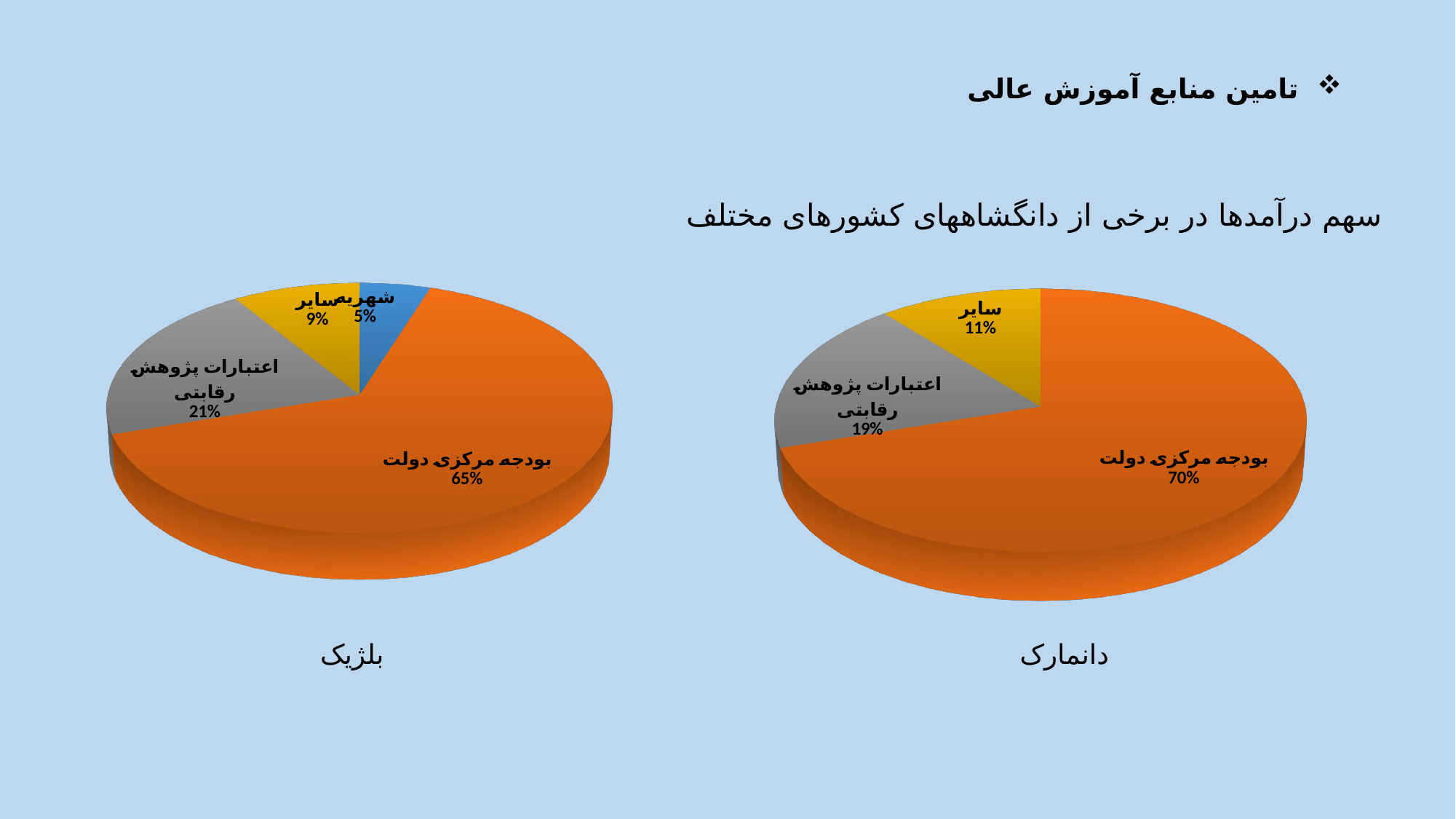
What is the difference between the بودجه مرکزی دولت share in the Denmark chart (right) and in the Belgium chart (left)? 5% Which chart shows a larger share for اعتبارات پژوهش رقابتی, the Belgium chart (left) or the Denmark chart (right)? Belgium (بلژیک) In the Denmark (دانمارک) pie chart on the right, what share is labelled for سایر? 11% In the Belgium (بلژیک) pie chart on the left, what share is labelled for اعتبارات پژوهش رقابتی? 21% In the Denmark (دانمارک) pie chart on the right, what share is labelled for اعتبارات پژوهش رقابتی? 19% How many slices does the Denmark (دانمارک) pie chart on the right have? 3 In the Denmark (دانمارک) pie chart on the right, what share is labelled for بودجه مرکزی دولت? 70% What type of chart is used for both countries on this slide? Pie chart In the Denmark (دانمارک) pie chart on the right, which category has the largest slice? بودجه مرکزی دولت In the Belgium (بلژیک) pie chart on the left, what share is labelled for بودجه مرکزی دولت? 65% In the Belgium (بلژیک) pie chart on the left, which category has the smallest slice? شهریه How many slices does the Belgium (بلژیک) pie chart on the left have? 4